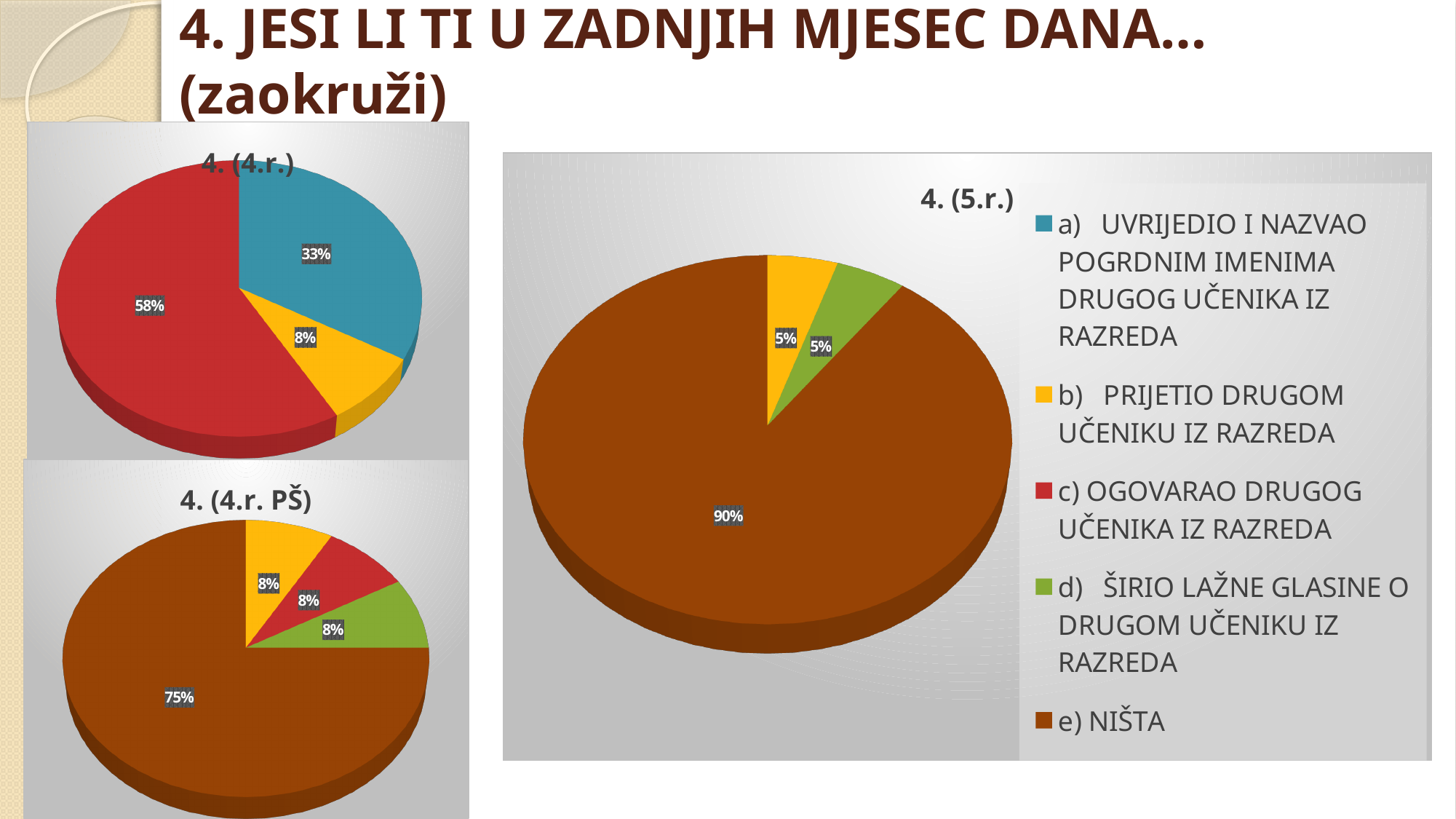
What type of chart is used for "4. (5.r.)"? Pie chart In the chart titled "4. (4.r.)", what percentage is shown for the blue slice (a) UVRIJEDIO I NAZVAO POGRDNIM IMENIMA DRUGOG UČENIKA IZ RAZREDA)? 33% Which is larger: the e) NIŠTA share in the "4. (5.r.)" chart or the e) NIŠTA share in the "4. (4.r. PŠ)" chart? 4. (5.r.) (90%) In the chart titled "4. (4.r. PŠ)", what percentage is shown for the green slice (d) ŠIRIO LAŽNE GLASINE O DRUGOM UČENIKU IZ RAZREDA)? 8% In the chart titled "4. (4.r.)", what percentage is shown for the red slice (c) OGOVARAO DRUGOG UČENIKA IZ RAZREDA)? 58% In the chart titled "4. (4.r.)", which slice is the largest? c) OGOVARAO DRUGOG UČENIKA IZ RAZREDA (58%) In the chart titled "4. (5.r.)", how many slices does the pie have? 3 In the chart titled "4. (4.r.)", what is the difference between the red slice (58%) and the blue slice (33%)? 25 percentage points In the chart titled "4. (4.r. PŠ)", how many slices does the pie have? 4 In the chart titled "4. (5.r.)", what percentage is shown for e) NIŠTA? 90% In the chart titled "4. (5.r.)", what percentage is shown for b) PRIJETIO DRUGOM UČENIKU IZ RAZREDA? 5% In the chart titled "4. (4.r. PŠ)", what percentage is shown for the brown slice (e) NIŠTA)? 75%